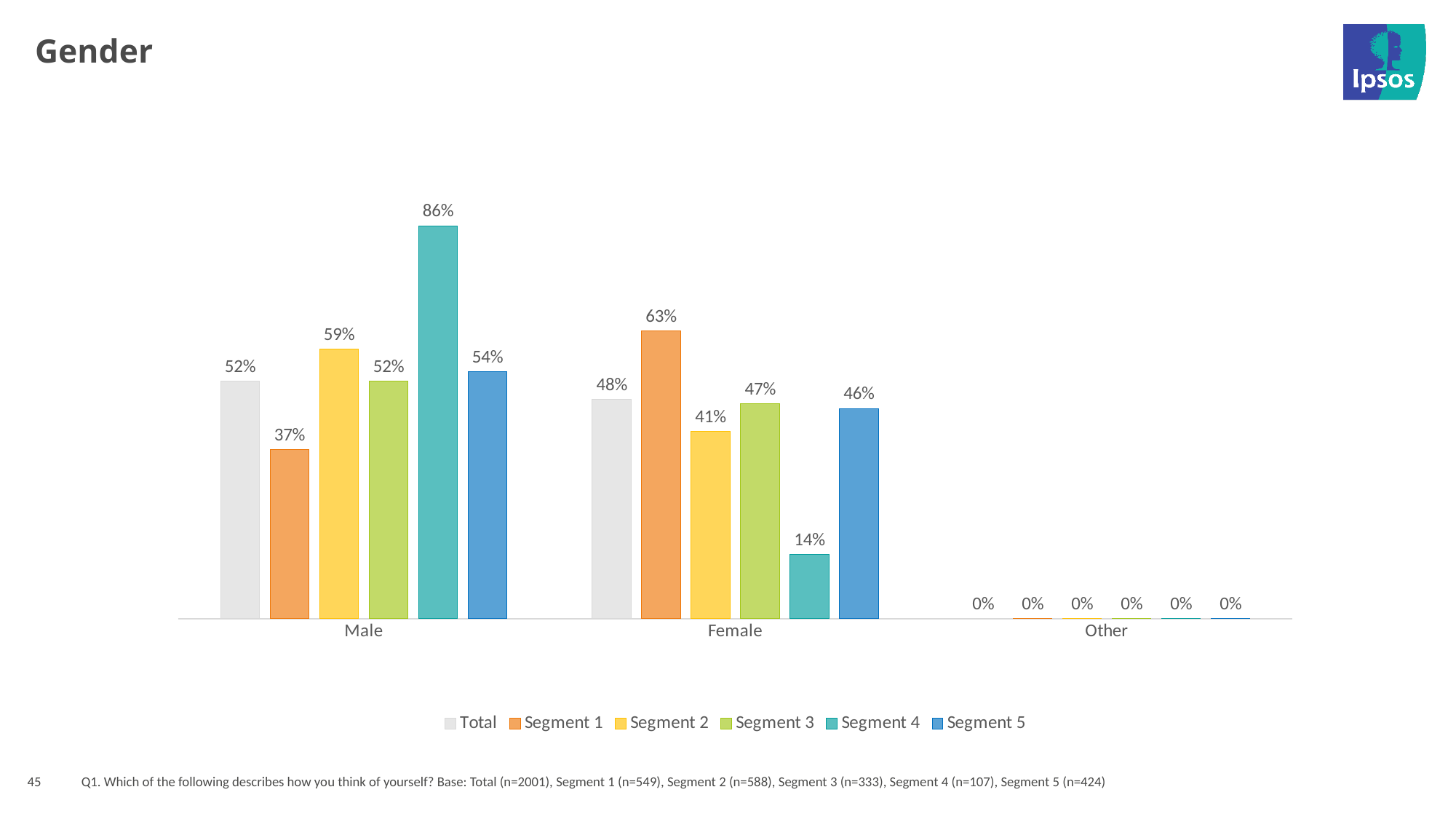
How many series does the legend list? 6 What is the difference between the Segment 4 values for Male and Female? 72% What is the value for every series in the Other category? 0% Which is larger: Segment 1 for Male or Segment 1 for Female? Segment 1 for Female What is the value for Segment 1 in the Female category? 63% What kind of chart is shown on the slide? Bar chart How many categories are shown on the x axis? 3 What is the Total value for Male? 52% What is the value for Segment 4 in the Male category? 86% Which series has the highest value in the Male category? Segment 4 What is the value for Segment 2 in the Female category? 41% Which series has the lowest value in the Female category? Segment 4